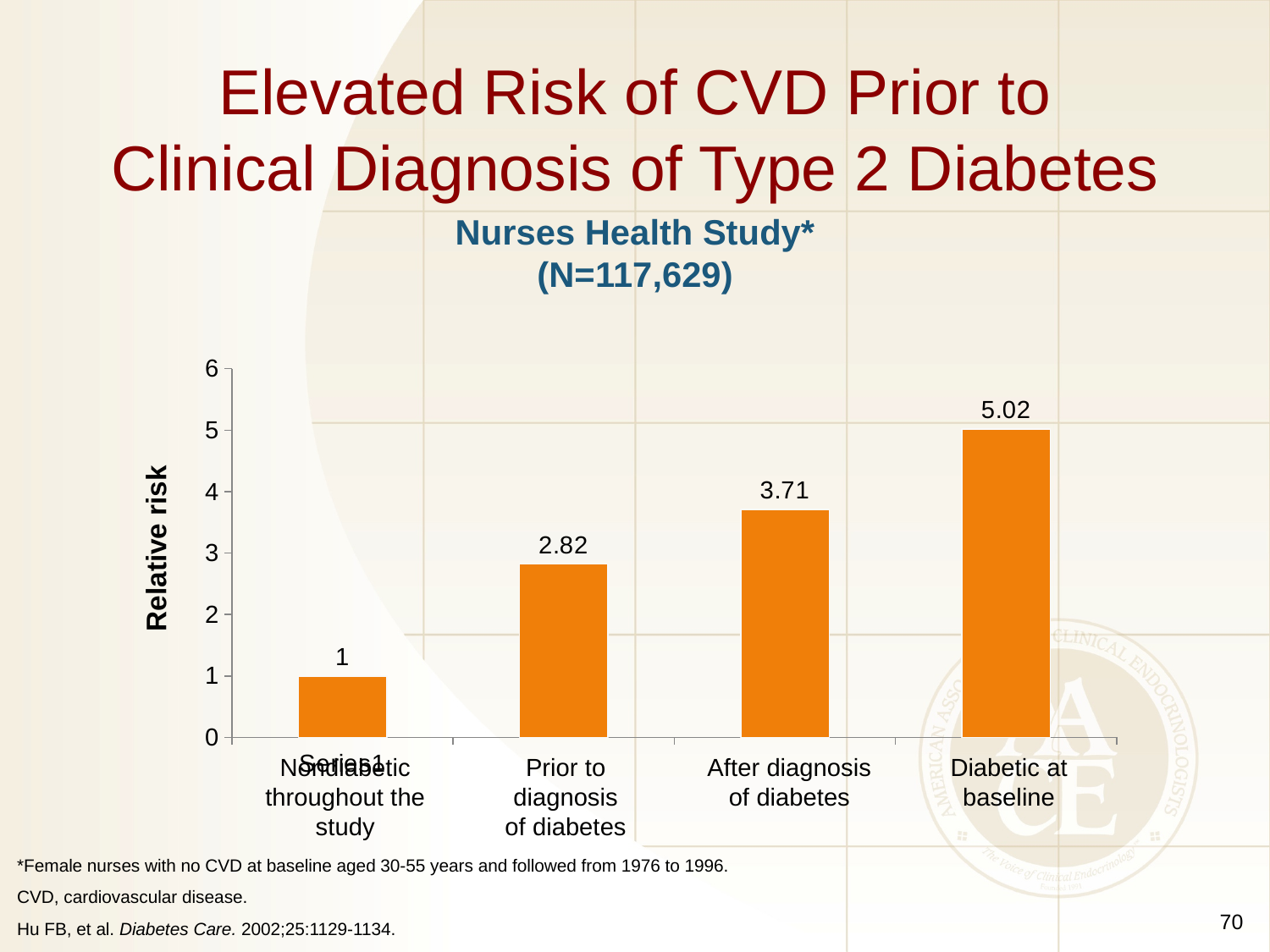
How many groups are plotted in the chart? 4 Which has a higher relative risk: 'After diagnosis of diabetes' or 'Prior to diagnosis of diabetes'? After diagnosis of diabetes Do the relative risk values rise or fall from left to right across the groups? Rise What is the relative risk for the 'After diagnosis of diabetes' group? 3.71 What kind of chart is shown on the slide? Bar chart Which group has the highest relative risk? Diabetic at baseline What is the label of the vertical axis of the chart? Relative risk What is the difference in relative risk between 'After diagnosis of diabetes' and 'Prior to diagnosis of diabetes'? 0.89 What is the relative risk for the 'Prior to diagnosis of diabetes' group? 2.82 What is the difference in relative risk between 'Diabetic at baseline' and 'Prior to diagnosis of diabetes'? 2.20 What is the relative risk for the 'Diabetic at baseline' group? 5.02 Which group has the lowest relative risk? Nondiabetic throughout the study